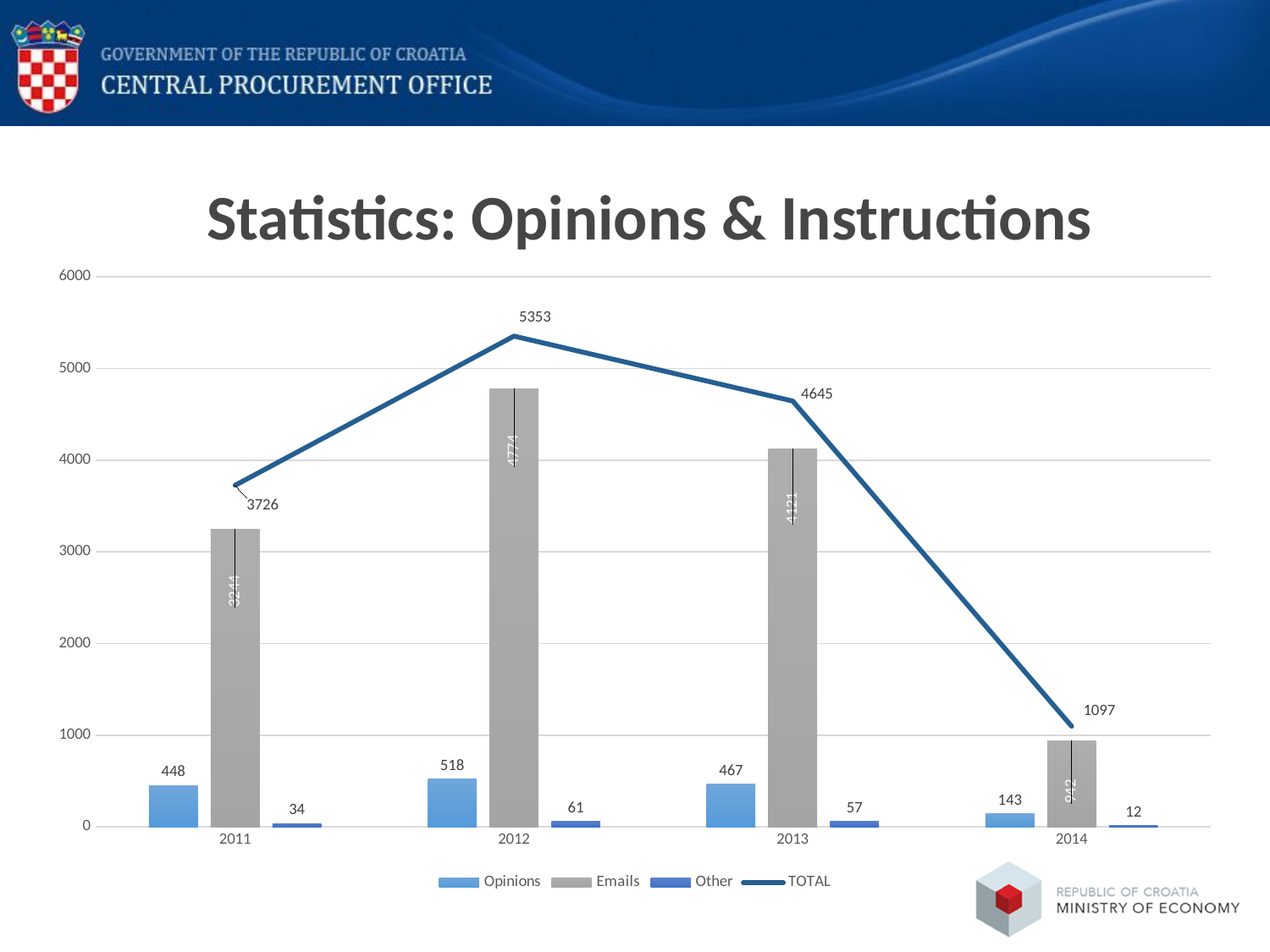
What is the value for Opinions in 2013? 467 Which year has the highest TOTAL value? 2012 Is the Emails value for 2013 greater or less than 4000? greater What is the difference between the TOTAL values for 2013 and 2014? 3548 How many series does the legend list? 4 What is the TOTAL value for 2012? 5353 Which year has the lowest value for Opinions? 2014 What is the value for Other in 2014? 12 Does the TOTAL line rise or fall from 2012 to 2014? fall What is the value for Emails in 2012? 4774 How many years are shown on the x axis? 4 Which is larger, the Opinions value for 2011 or for 2012? 2012